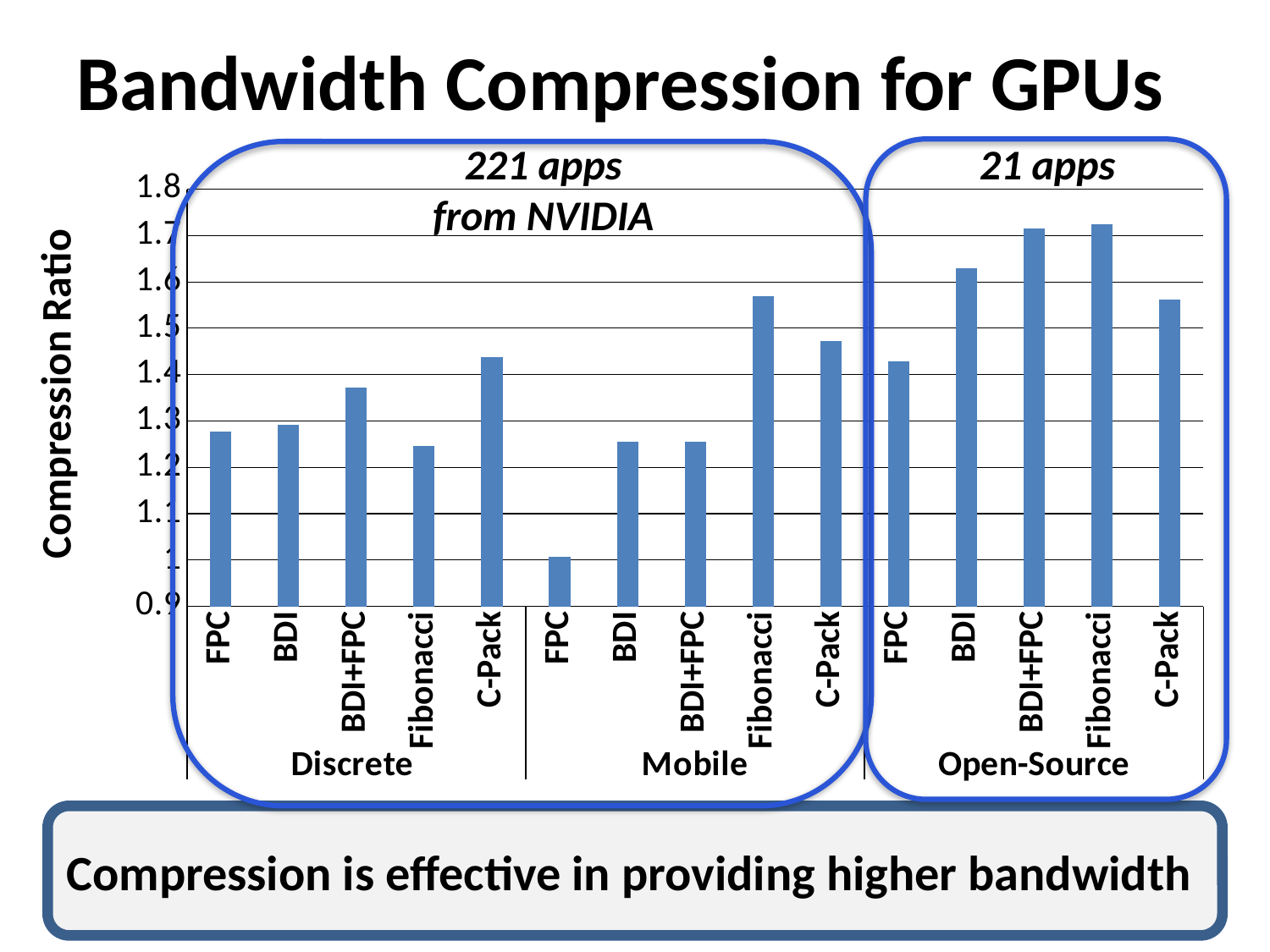
How many bars are plotted in the chart? 15 What is the label of the y axis of the chart? Compression Ratio What kind of chart is shown on the slide? bar chart Is the compression ratio for Fibonacci in the Mobile group greater or less than 1.5? greater Within the Open-Source group, which compression algorithm has the lowest compression ratio? FPC Within the Discrete group, which compression algorithm has the highest compression ratio? C-Pack Is the compression ratio for BDI in the Open-Source group greater or less than 1.6? greater Which bar has the lowest compression ratio in the chart? FPC (Mobile) Is the compression ratio for FPC in the Mobile group greater or less than 1.1? less How many GPU groups are shown along the x axis of the chart? 3 Which has a higher compression ratio: C-Pack in the Discrete group or C-Pack in the Open-Source group? C-Pack in the Open-Source group Within the Mobile group, which compression algorithm has the highest compression ratio? Fibonacci